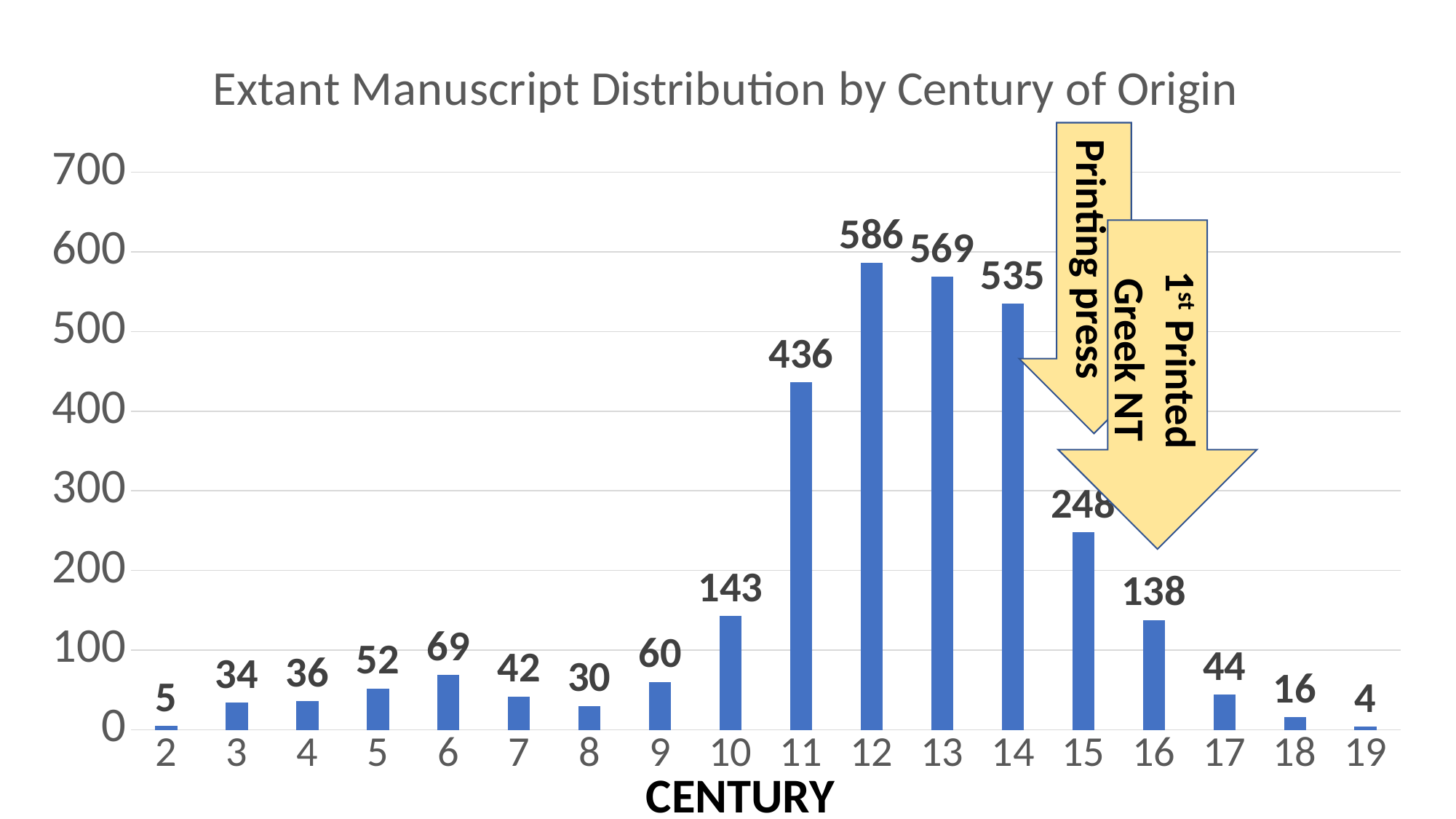
What is the value for century 6? 69 What is the difference between the values for century 11 and century 10? 293 Which is larger, the value for century 14 or the value for century 15? century 14 What is the difference between the values for century 12 and century 13? 17 What is the value for century 15? 248 What is the title of the chart? Extant Manuscript Distribution by Century of Origin What is the value for century 12? 586 Which century has the lowest value? 19 How many centuries are shown on the x axis? 18 Which century has the highest value? 12 What kind of chart is shown on the slide? bar chart Is the value for century 11 greater or less than 400? greater